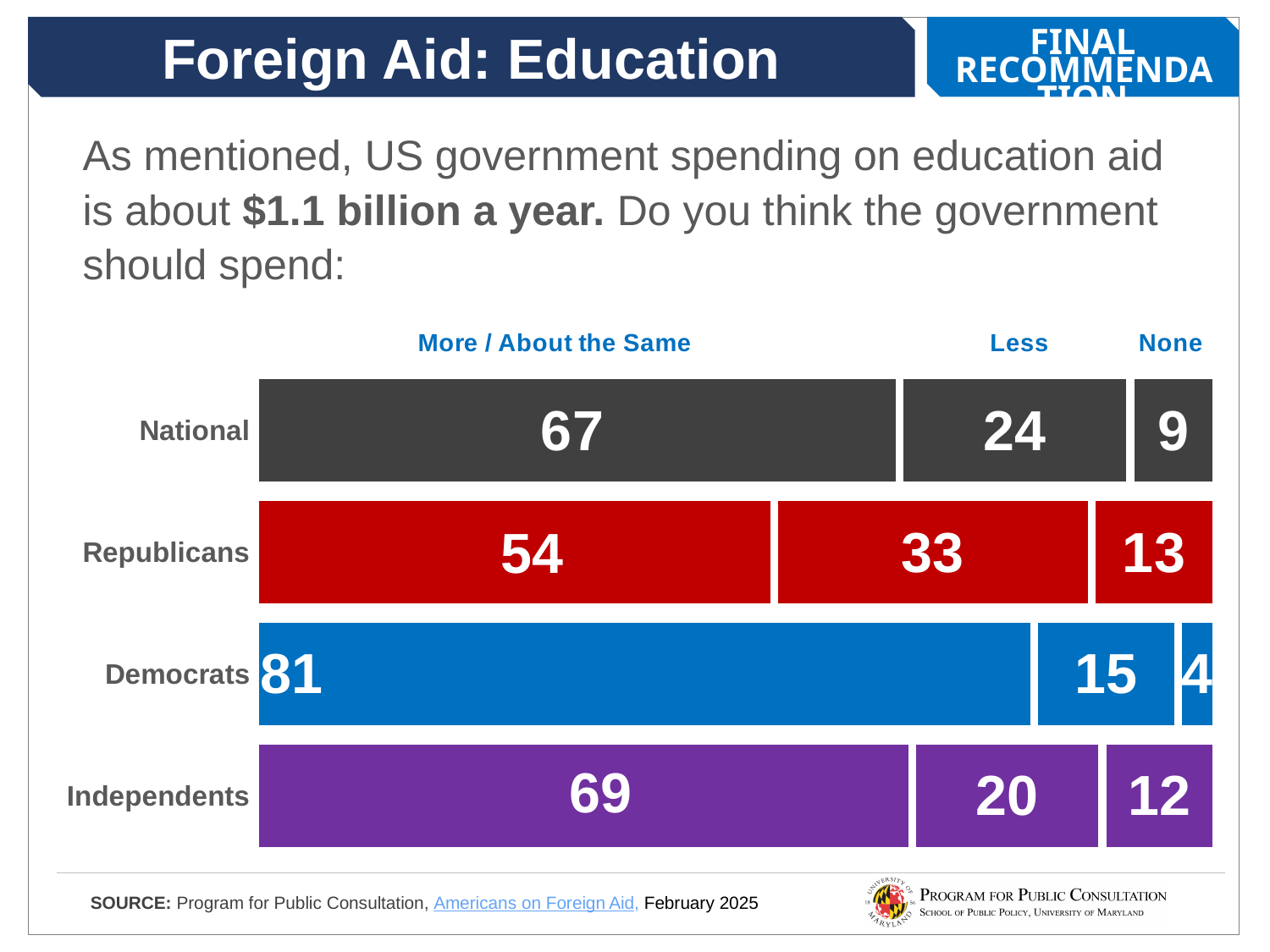
What is the total of the Republicans bar? 100 How many response categories are shown across the top of the chart? 3 Which group has the highest value for More / About the Same? Democrats What is the National value for More / About the Same? 67 What is the Independents value for Less? 20 What is the difference between the Republicans and Democrats values for More / About the Same? 27 What is the Republicans value for Less? 33 What kind of chart is shown on the slide? Stacked bar chart What is the Democrats value for None? 4 Which group has the lowest value for None? Democrats Which is larger: the Less value for Republicans or for Independents? Republicans How many groups are shown in the chart? 4